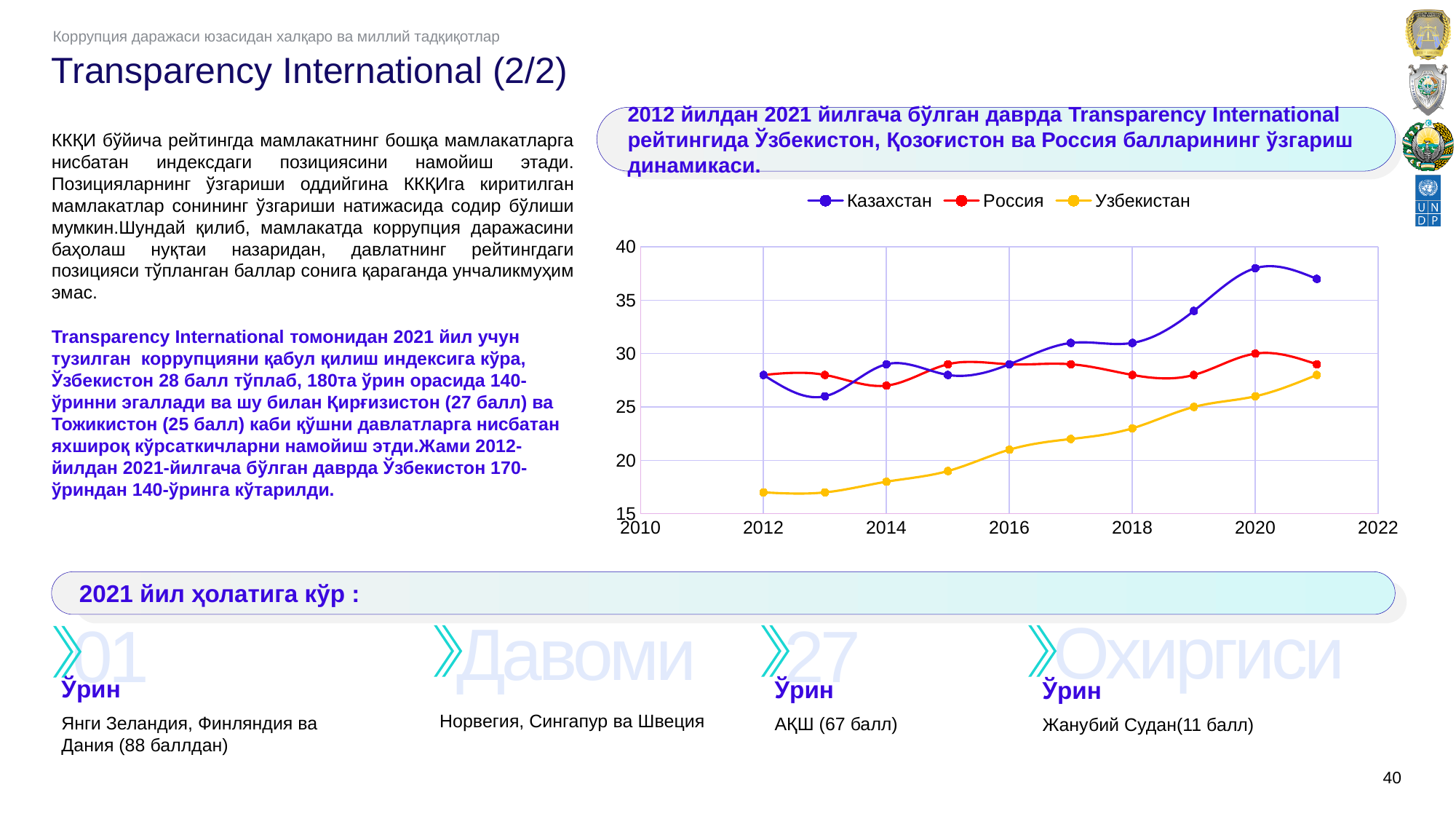
Do the values for Узбекистан rise or fall from 2012 to 2021? rise What kind of chart is shown on the slide? line chart Which series has the lowest value in 2012? Узбекистан How many series does the chart legend list? 3 How many data points are plotted for the Узбекистан series? 10 Is the value for Казахстан in 2013 greater or less than 30? less Is the value for Узбекистан in 2012 greater or less than 20? less Which is larger in 2020, the value for Казахстан or the value for Узбекистан? Казахстан Is the value for Казахстан in 2020 greater or less than 35? greater Which series has the highest value in 2021? Казахстан Which series is shown in yellow in the chart? Узбекистан